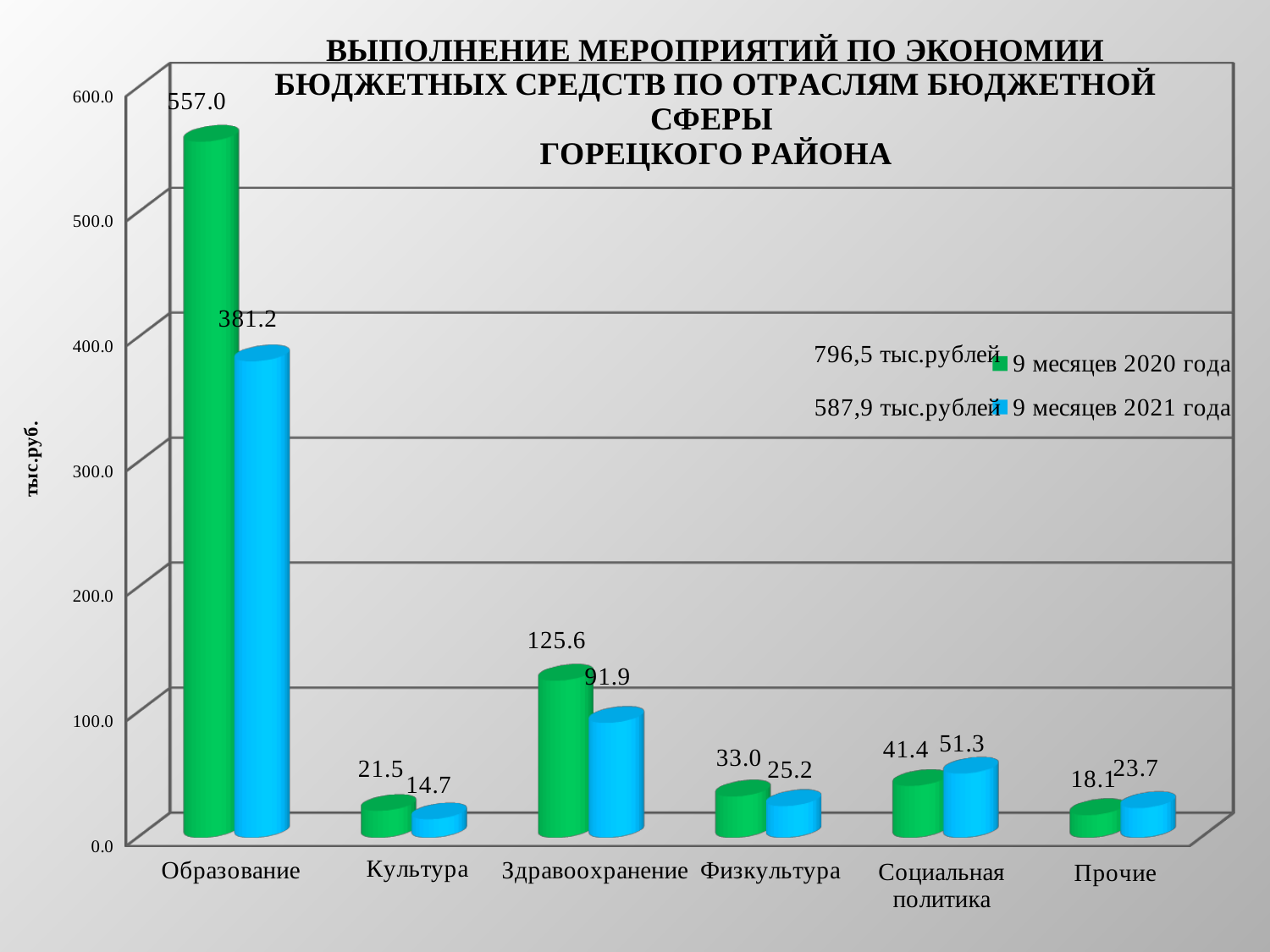
For Социальная политика, which series has the larger value: 9 месяцев 2020 года or 9 месяцев 2021 года? 9 месяцев 2021 года Which category has the highest value in the series 9 месяцев 2020 года? Образование What is the difference between the 9 месяцев 2020 года and 9 месяцев 2021 года values for Образование? 175.8 What is the value for Здравоохранение in the series 9 месяцев 2021 года? 91.9 What type of chart is shown on the slide? Bar chart How many categories are shown on the x axis? 6 What is the value for Прочие in the series 9 месяцев 2020 года? 18.1 What unit is shown on the vertical axis label? тыс.руб. How many series does the legend list? 2 What is the value for Социальная политика in the series 9 месяцев 2021 года? 51.3 Which category has the lowest value in the series 9 месяцев 2021 года? Культура What is the value for Образование in the series 9 месяцев 2020 года? 557.0